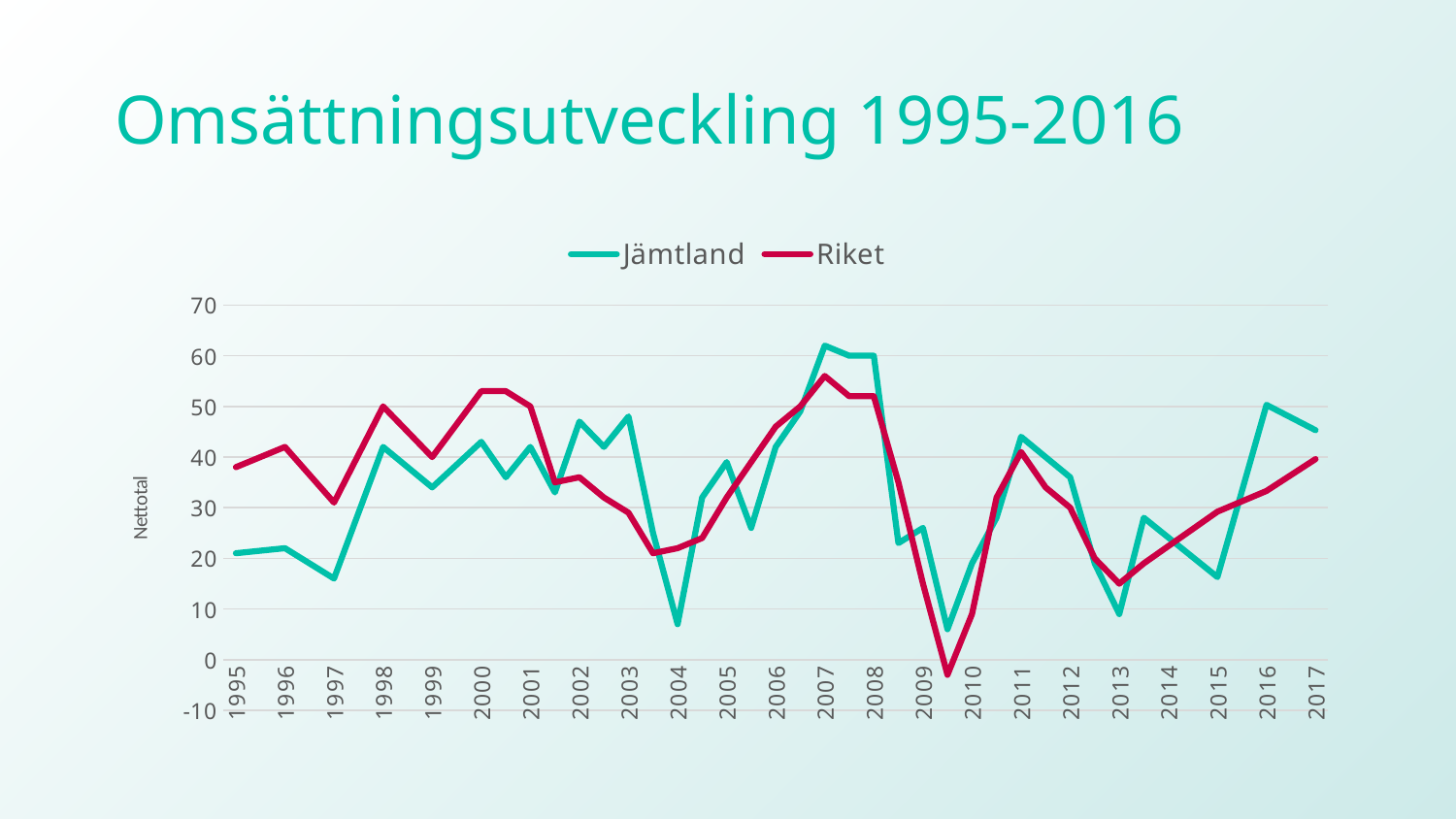
Is the value for Riket in 1995 greater or less than 30? greater Is the value for Jämtland in 1995 greater or less than 30? less What label is shown on the vertical axis? Nettotal Which series has the higher value in 2016, Jämtland or Riket? Jämtland What is the title of the chart on the slide? Omsättningsutveckling 1995-2016 How many series does the legend list? 2 Does the Riket line rise or fall from 2013 to 2017? rise How many year labels are shown along the x axis? 23 What kind of chart is shown on the slide? Line chart Is the lowest value of the Riket line greater or less than 0? less Which series has the higher value in 2007, Jämtland or Riket? Jämtland